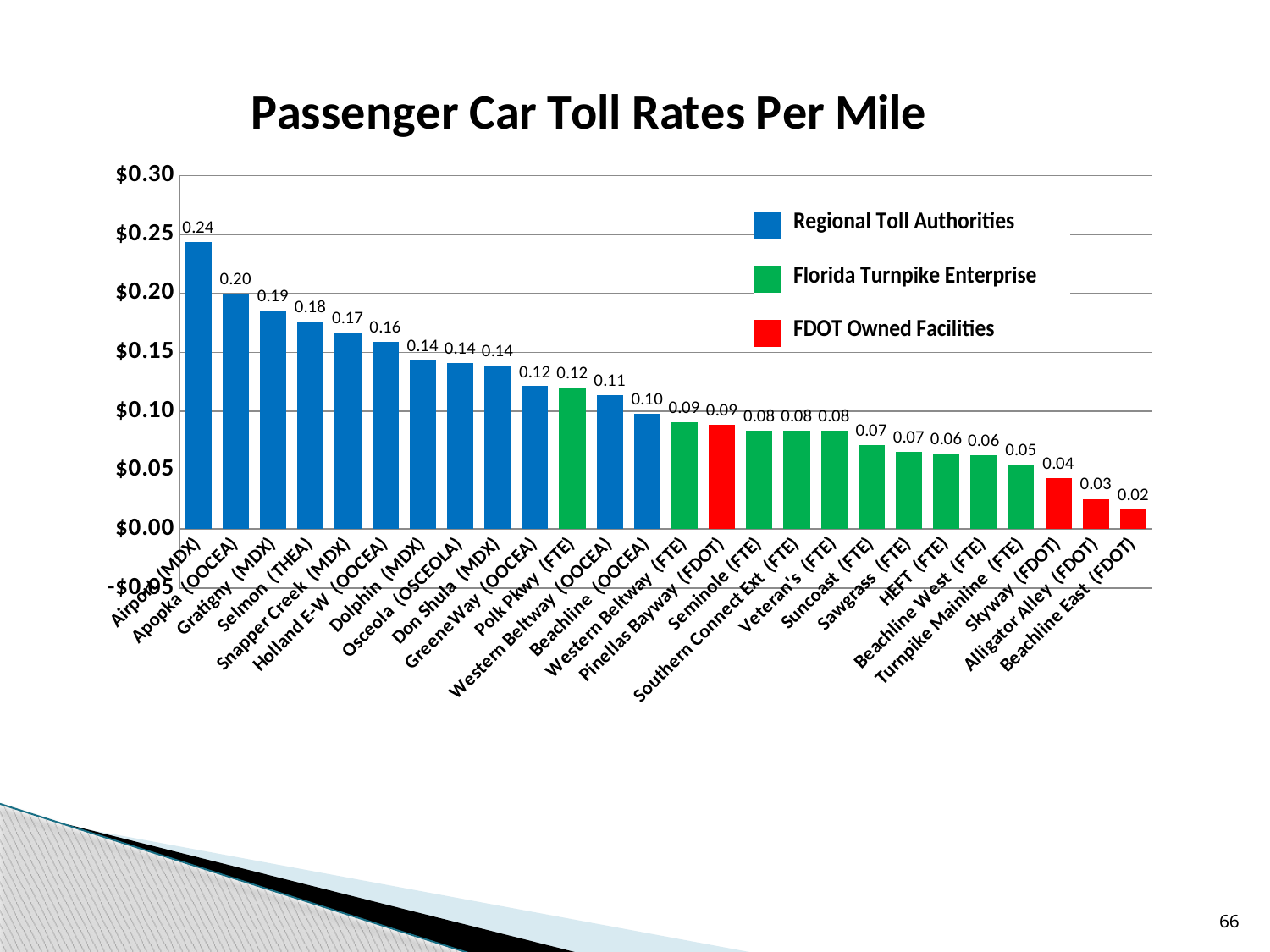
What is the toll rate per mile for Airport (MDX)? 0.24 Which facility has the lowest toll rate per mile? Beachline East (FDOT) What is the toll rate per mile for Turnpike Mainline (FTE)? 0.05 Which facility has the highest toll rate per mile? Airport (MDX) How many facilities are shown on the chart? 26 Do the toll rates rise or fall moving from left to right along the x axis? Fall Which has a higher toll rate per mile, Gratigny (MDX) or Polk Pkwy (FTE)? Gratigny (MDX) How many entries does the legend list? 3 What kind of chart is shown on the slide? Bar chart What is the toll rate per mile for Pinellas Bayway (FDOT)? 0.09 What is the difference between the toll rate per mile for Apopka (OOCEA) and Skyway (FDOT)? 0.16 What is the toll rate per mile for Selmon (THEA)? 0.18